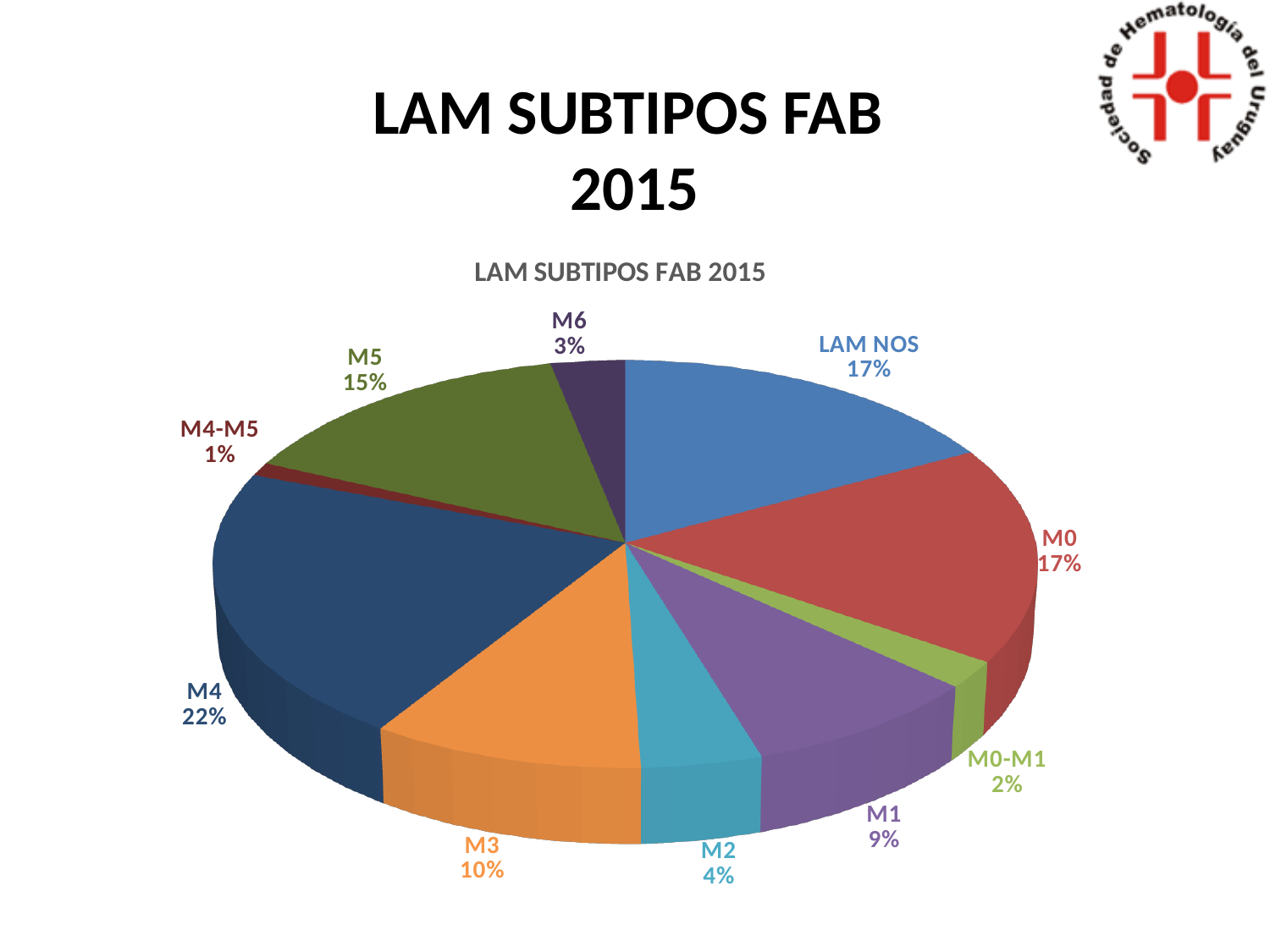
What percentage share does M4 have? 22% What percentage share does M5 have? 15% Which subtype has the smallest share of the pie? M4-M5 What type of chart is shown on the slide? pie chart Which subtype has the largest share of the pie? M4 What is the chart's title? LAM SUBTIPOS FAB 2015 What is the combined share of M0 and M0-M1? 19% Which has a larger share, M5 or M1? M5 What percentage share does LAM NOS have? 17% How many slices does the pie chart have? 10 What percentage share does M1 have? 9% What is the difference in percentage points between M4 and M3? 12